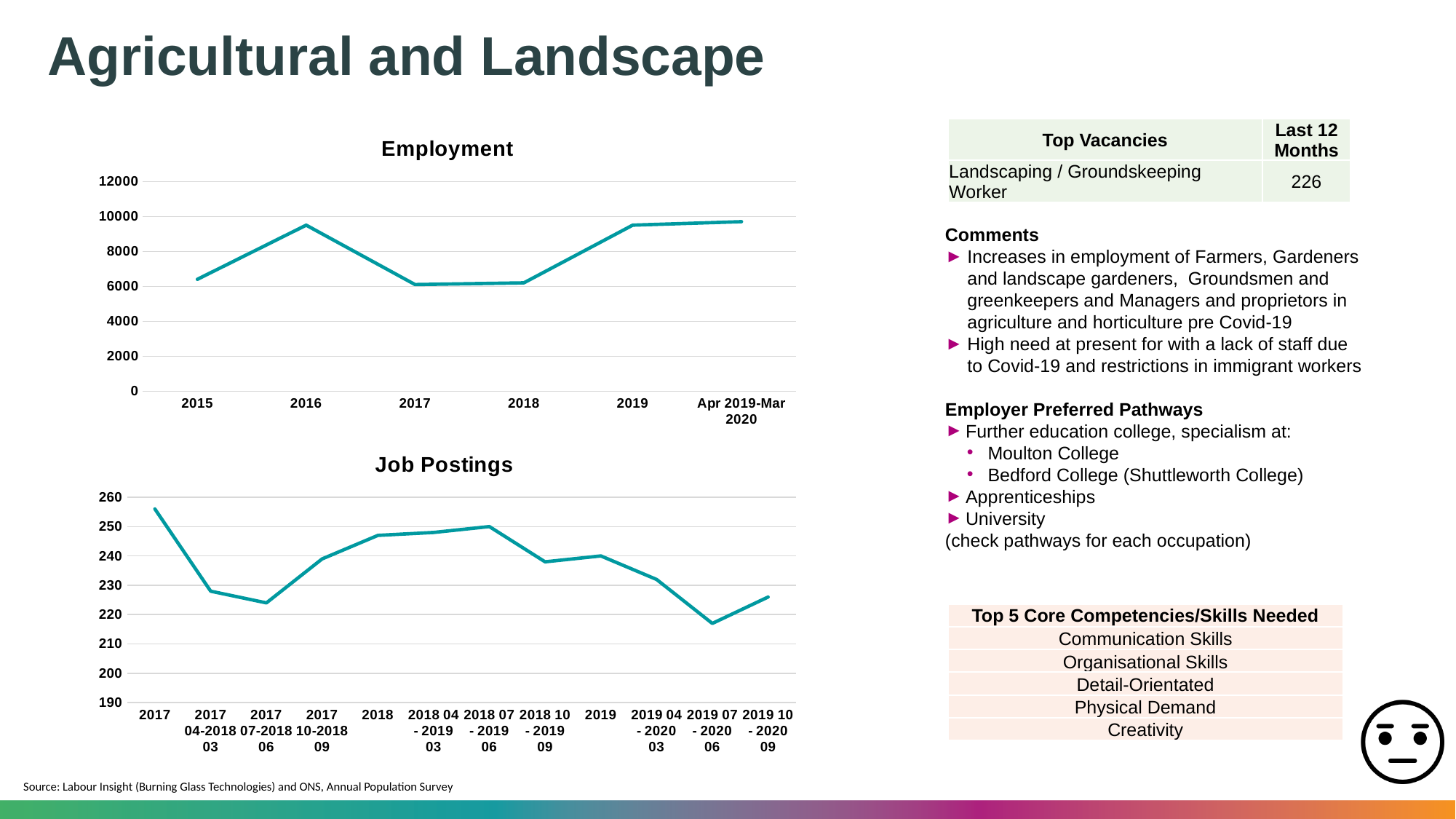
On the Employment chart, which is larger, the value for 2016 or the value for 2017? 2016 On the Job Postings chart, which period has the lowest value? 2019 07 - 2020 06 How many data points are plotted on the Job Postings chart? 12 On the Employment chart, is the value for 2016 greater or less than 8000? greater On the Employment chart, is the value for 2017 greater or less than 8000? less On the Job Postings chart, which period has the highest value? 2017 On the Employment chart, does the value rise or fall from 2018 to 2019? rise On the Job Postings chart, is the value for 2017 greater or less than 250? greater What kind of chart is the Job Postings chart? line chart What kind of chart is the Employment chart? line chart How many data points are plotted on the Employment chart? 6